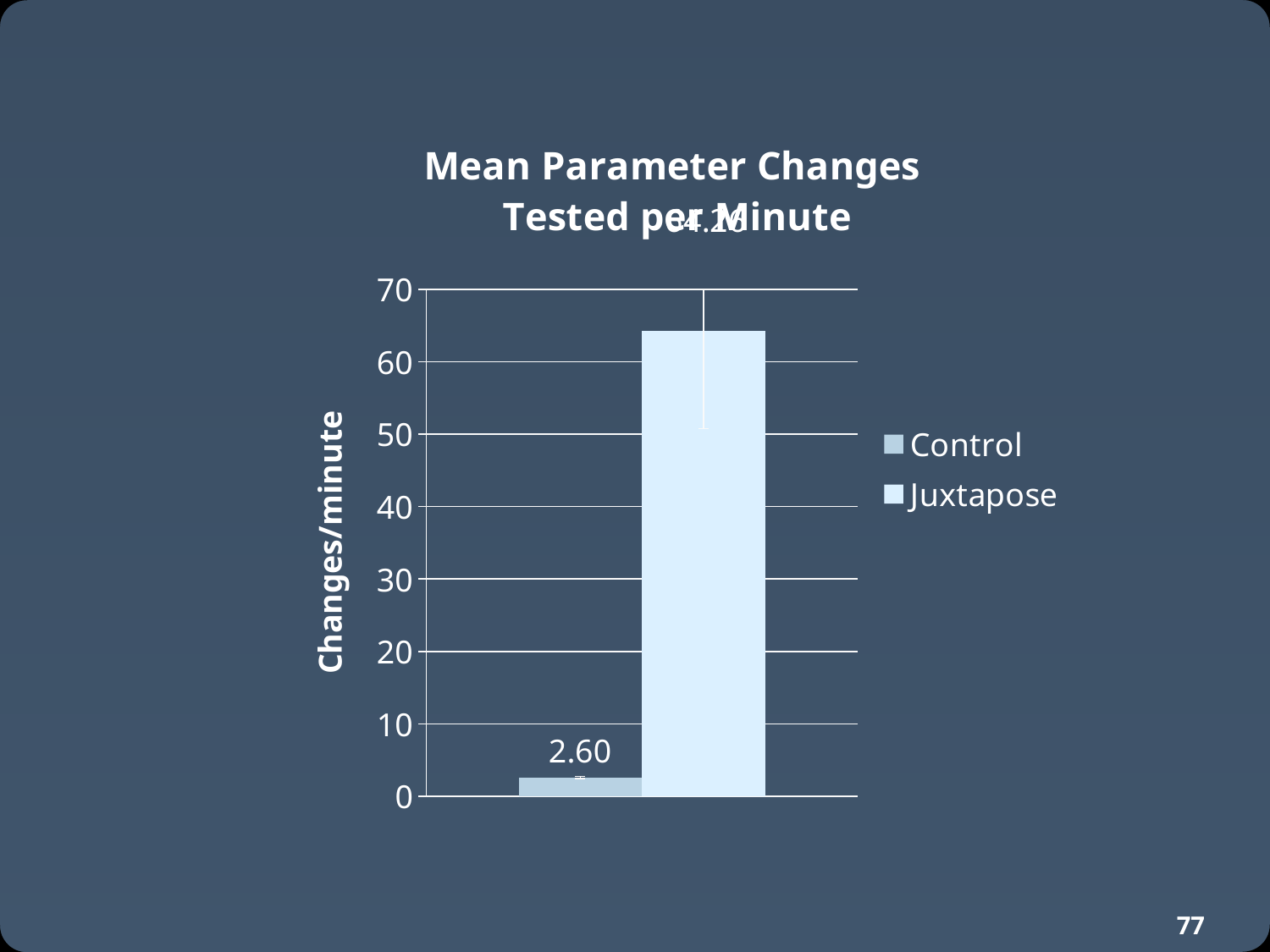
Is the value for Juxtapose greater or less than 60? greater What is the maximum value shown on the vertical axis? 70 What is the label on the vertical axis? Changes/minute Which series has the highest value? Juxtapose How many series does the legend list? 2 Is the value for Control greater or less than 10? less What is the value for Control? 2.60 What kind of chart is shown? Bar chart Which series has the higher value, Control or Juxtapose? Juxtapose What is the title of the chart? Mean Parameter Changes Tested per Minute Is the value for Juxtapose greater or less than 70? less Which series has the lowest value? Control